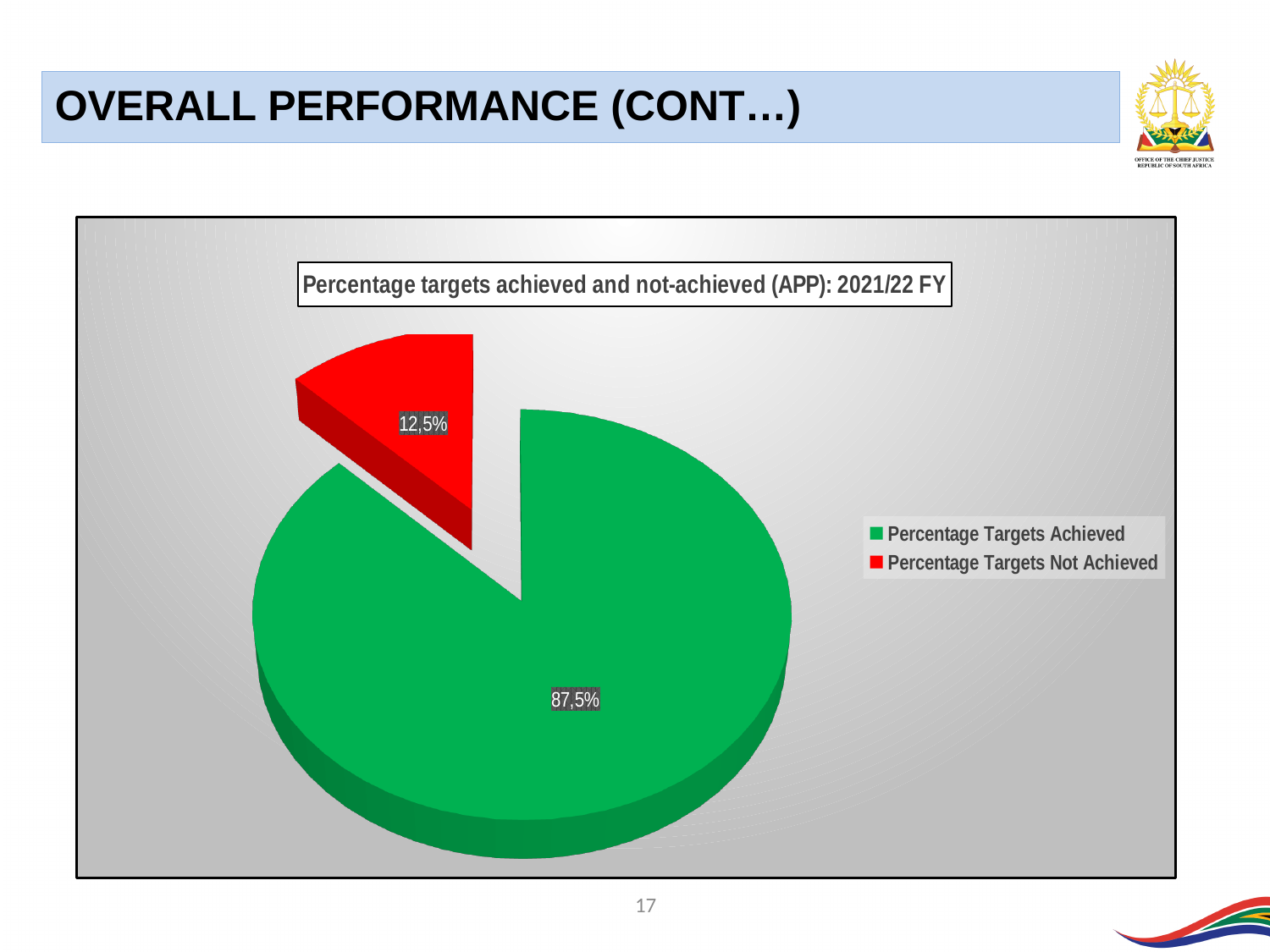
What share of the pie does the Percentage Targets Achieved slice represent? 87,5% Which category has the largest slice of the pie? Percentage Targets Achieved What type of chart is shown on the slide? pie chart How many slices does the pie chart have? 2 How many entries does the legend list? 2 What percentage of targets were not achieved according to the chart? 12,5% What percentage of targets were achieved according to the chart? 87,5% Which category has the smallest slice of the pie? Percentage Targets Not Achieved Which is larger: the share of targets achieved or the share of targets not achieved? Percentage Targets Achieved What is the title of the chart? Percentage targets achieved and not-achieved (APP): 2021/22 FY What colour is the slice for Percentage Targets Not Achieved? red What is the difference between the percentage of targets achieved and the percentage not achieved? 75%